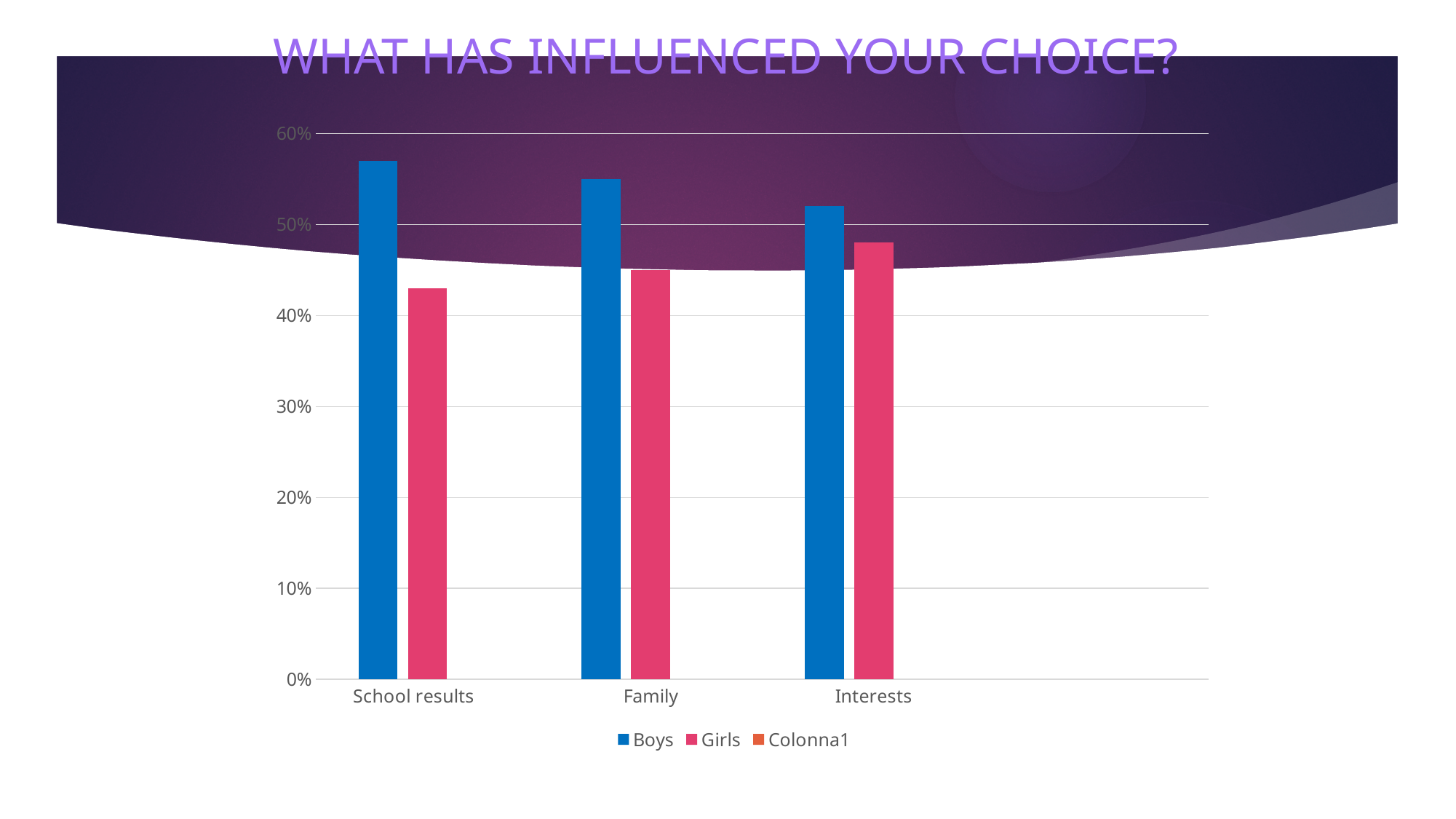
In the Interests category, which is larger, Boys or Girls? Boys Is the value for Girls in Family greater or less than 40%? greater Is the value for Boys in Family greater or less than 50%? greater For which category is the Boys value lowest? Interests For which category is the Girls value lowest? School results Do the Girls values rise or fall from School results to Interests? rise How many categories are shown on the x axis? 3 Is the value for Boys in School results greater or less than 50%? greater What kind of chart is shown on the slide? bar chart For which category is the Girls value highest? Interests How many series does the legend list? 3